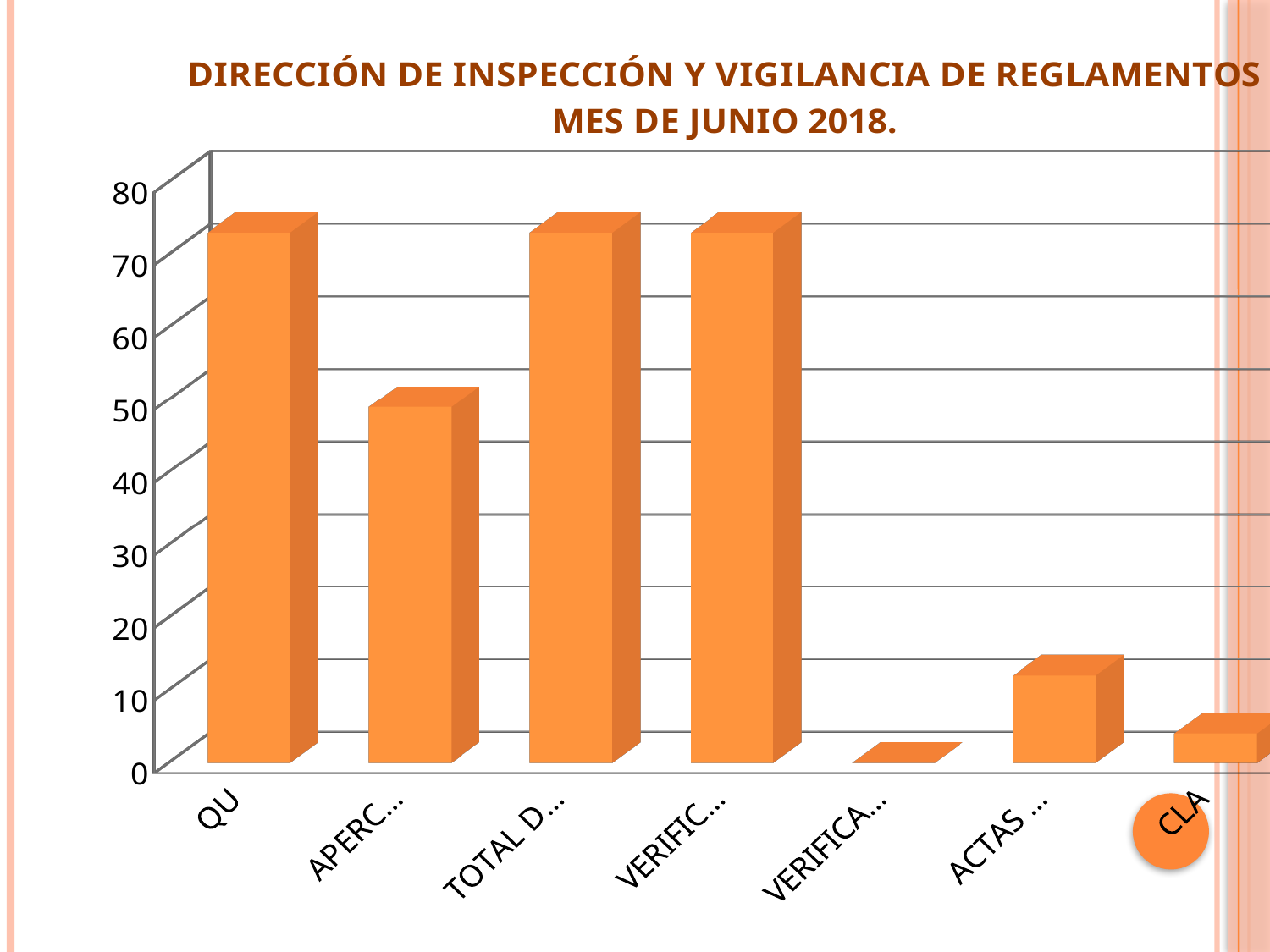
Which is larger, the value for QU or the value for APERC...? QU What colour are the bars in the chart? orange What is the title of the chart? DIRECCIÓN DE INSPECCIÓN Y VIGILANCIA DE REGLAMENTOS MES DE JUNIO 2018. Which category has the lowest value? VERIFICA... Is the value for QU greater or less than 60? greater Which is larger, the value for ACTAS ... or the value for CLA? ACTAS ... Is the value for TOTAL D... greater or less than 60? greater How many categories are plotted along the x axis? 7 What kind of chart is shown on the slide? bar chart Is the value for CLA greater or less than 10? less